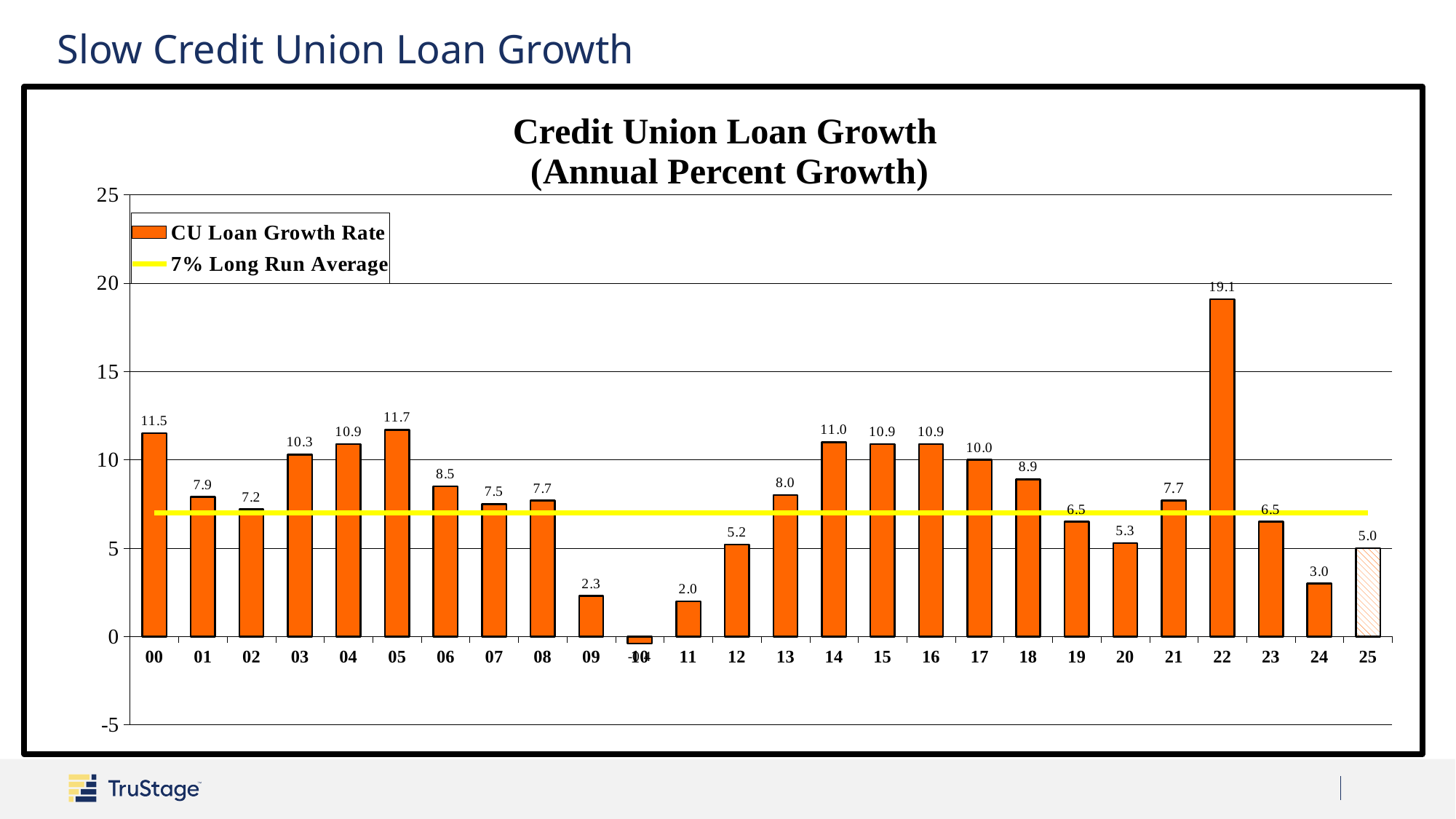
Which year has the highest CU Loan Growth Rate? 22 Is the CU Loan Growth Rate for 24 greater or less than 5? less Which year has the lowest CU Loan Growth Rate? 10 Which year has a higher CU Loan Growth Rate, 14 or 17? 14 What is the difference between the CU Loan Growth Rate for 22 and for 23? 12.6 What is the CU Loan Growth Rate for 05? 11.7 What value does the yellow line in the chart represent? 7% Long Run Average What is the CU Loan Growth Rate for 25? 5.0 How many years are shown on the x axis? 26 How many series does the legend list? 2 What kind of chart is shown? combination bar and line chart What is the CU Loan Growth Rate for 22? 19.1